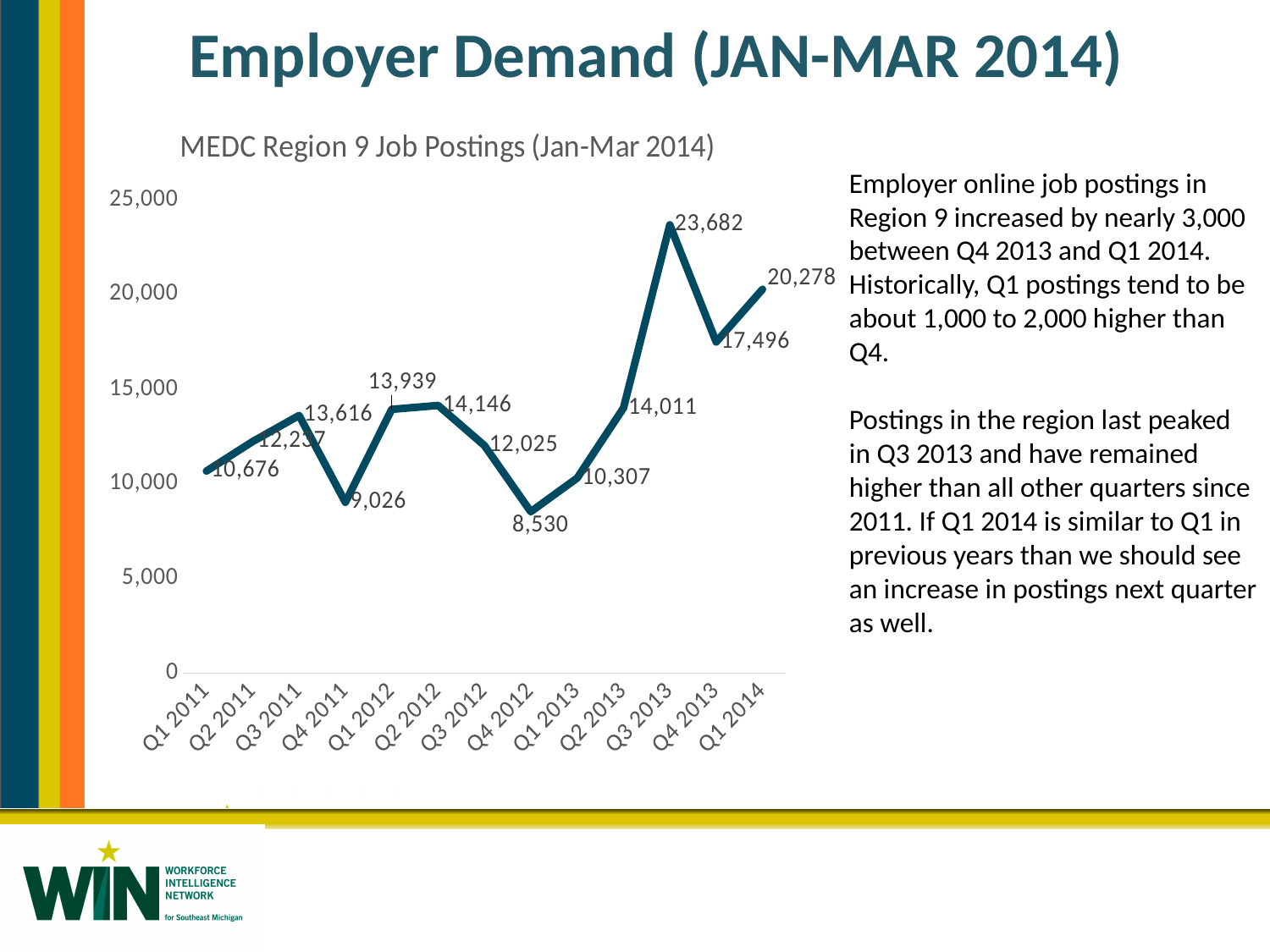
What is the value for Q4 2012? 8,530 What is the value for Q3 2013? 23,682 Is the value for Q4 2013 greater or less than 15,000? greater Which quarter has the lowest number of job postings? Q4 2012 What is the difference between the values for Q1 2014 and Q4 2013? 2,782 How many quarters are plotted on the chart? 13 Do the values rise or fall from Q4 2012 to Q3 2013? Rise Which is larger, the value for Q2 2012 or the value for Q2 2013? Q2 2012 What type of chart is shown on the slide? Line chart Which quarter has the highest number of job postings? Q3 2013 What is the value for Q1 2014? 20,278 What is the title of the chart? MEDC Region 9 Job Postings (Jan-Mar 2014)